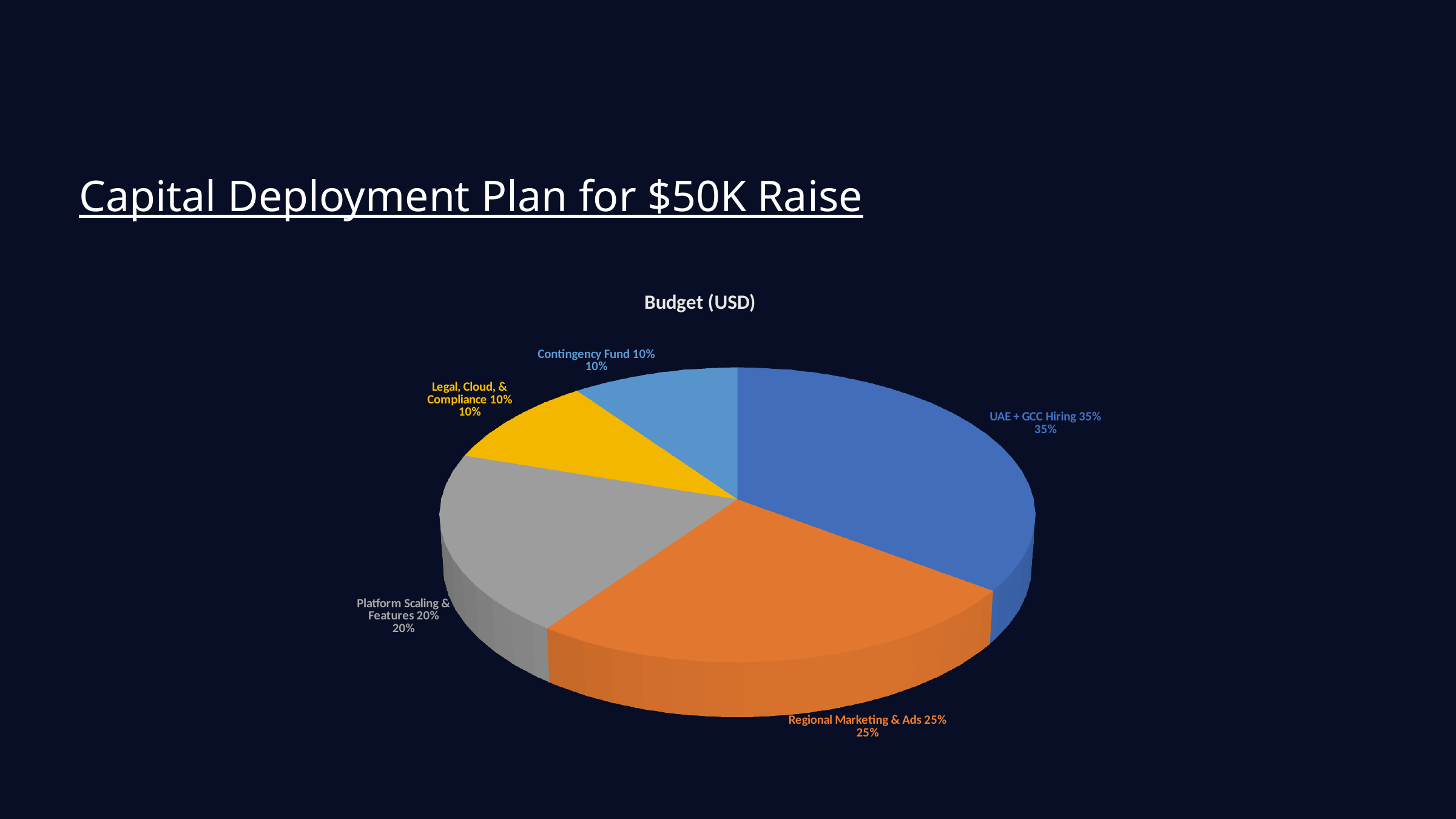
Which category has the largest share of the budget? UAE + GCC Hiring What kind of chart is shown on the slide? pie chart What share of the budget goes to Legal, Cloud, & Compliance? 10% Which is larger: the share for Regional Marketing & Ads or the share for Platform Scaling & Features? Regional Marketing & Ads What share of the budget goes to Regional Marketing & Ads? 25% What is the title of the chart? Budget (USD) What is the difference in percentage points between the UAE + GCC Hiring share and the Regional Marketing & Ads share? 10% What colour is the slice for Regional Marketing & Ads? orange How many slices does the pie chart have? 5 What share of the budget goes to Platform Scaling & Features? 20%